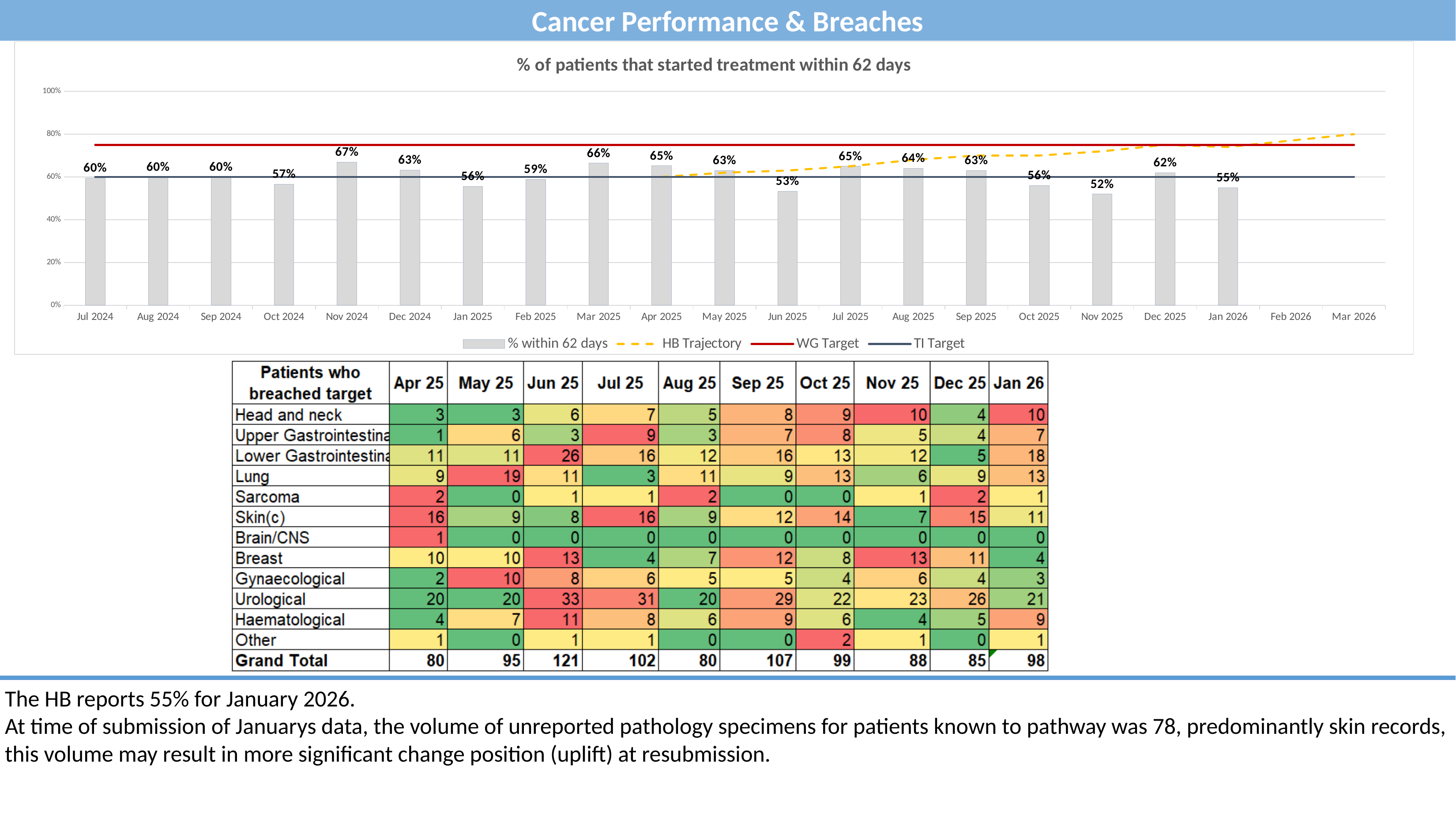
Is the '% within 62 days' value for Dec 2025 greater or less than 80%? less How many series does the legend of the chart list? 4 What is the value for Jan 2026 in the '% of patients that started treatment within 62 days' chart? 55% Which is larger in the chart: the '% within 62 days' value for Mar 2025 or for Oct 2025? Mar 2025 Which month has the lowest '% within 62 days' value in the chart? Nov 2025 What is the difference between the '% within 62 days' values for Nov 2024 and Nov 2025? 15% Which month has the highest '% within 62 days' value in the chart? Nov 2024 Which legend entry in the chart is shown as a dashed yellow line? HB Trajectory How many months have a '% within 62 days' bar plotted in the chart? 19 What is the value for Jun 2025 in the '% of patients that started treatment within 62 days' chart? 53% What is the value for Nov 2024 in the '% of patients that started treatment within 62 days' chart? 67% What kind of chart is used to show the '% within 62 days' values? Bar chart